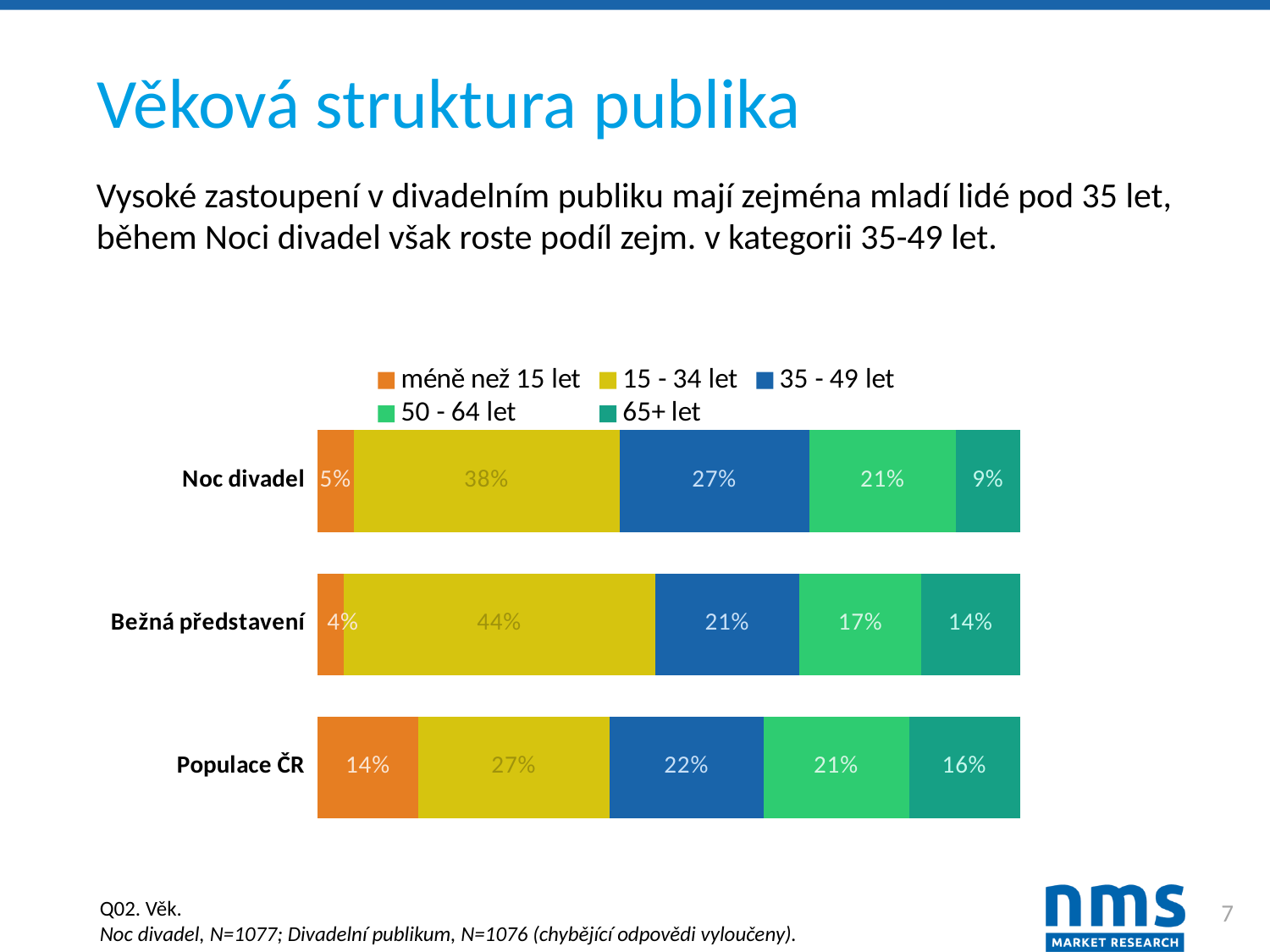
What kind of chart is shown on the slide? Stacked bar chart Which is larger: the 50 - 64 let value for Noc divadel or for Bežná představení? Noc divadel What is the difference between the 35 - 49 let values for Noc divadel and Bežná představení? 6% What is the value for méně než 15 let in the Populace ČR bar? 14% What is the value for 15 - 34 let in the Noc divadel bar? 38% Which category has the highest value for 15 - 34 let? Bežná představení How many series does the legend list? 5 What is the value for 35 - 49 let in the Bežná představení bar? 21% How many categories (bars) are shown in the chart? 3 What is the value for 65+ let in the Noc divadel bar? 9% Which category has the lowest value for 65+ let? Noc divadel What is the total of the Populace ČR stacked bar? 100%